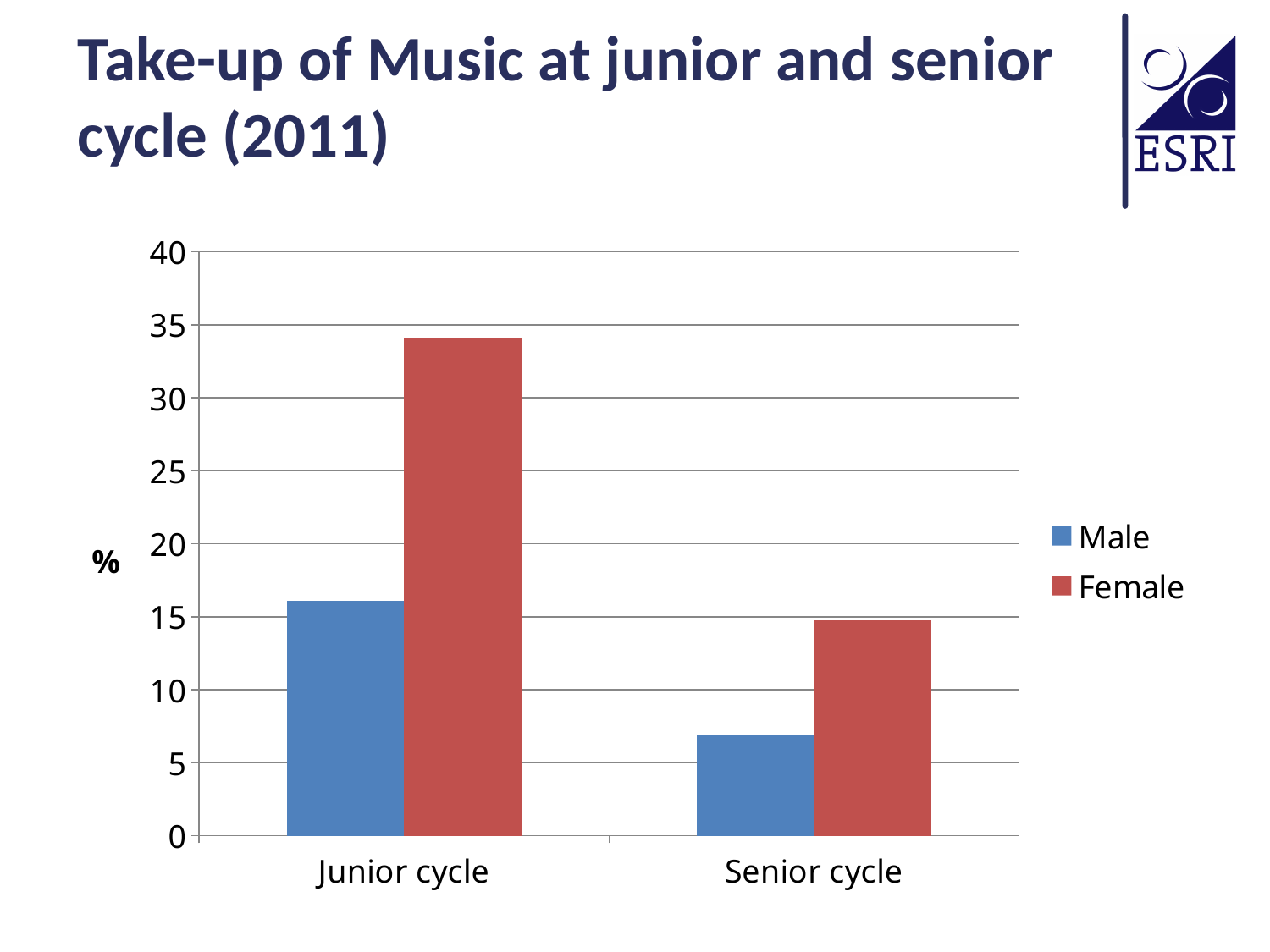
Is the Male value for Senior cycle greater or less than 10? less What kind of chart is shown on the slide? bar chart How many categories are shown on the x axis? 2 Which is larger at Senior cycle, the Male value or the Female value? Female Is the Female value for Junior cycle greater or less than 30? greater Is the Male value for Junior cycle greater or less than 20? less What is the title of the chart on the slide? Take-up of Music at junior and senior cycle (2011) Which bar is the lowest in the chart? Male, Senior cycle Which series has the highest value in the chart? Female Do the Female values rise or fall from Junior cycle to Senior cycle? fall How many series does the legend list? 2